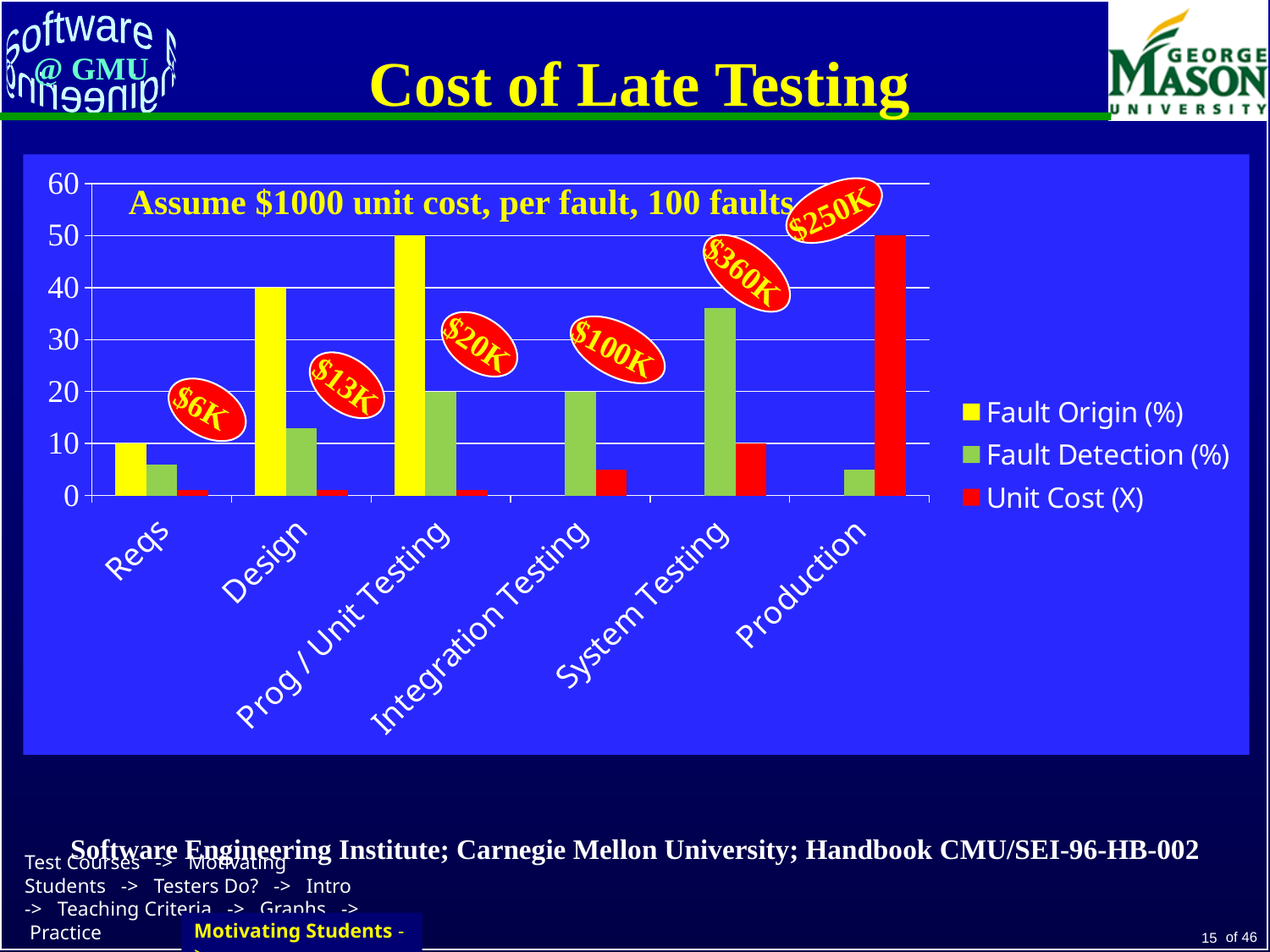
How many series does the legend list? 3 What is the Fault Origin (%) value for Design? 40 Which category has the highest Fault Origin (%) value? Prog / Unit Testing What is the Unit Cost (X) value for System Testing? 10 Which category has the highest Unit Cost (X) value? Production What is the Fault Origin (%) value for Prog / Unit Testing? 50 Which category has the highest Fault Detection (%) value? System Testing Which is larger for Design: Fault Origin (%) or Fault Detection (%)? Fault Origin (%) What kind of chart is shown on the slide? bar chart How many categories are shown along the x axis? 6 What is the Unit Cost (X) value for Production? 50 Is the Fault Detection (%) value for System Testing greater or less than 30? greater